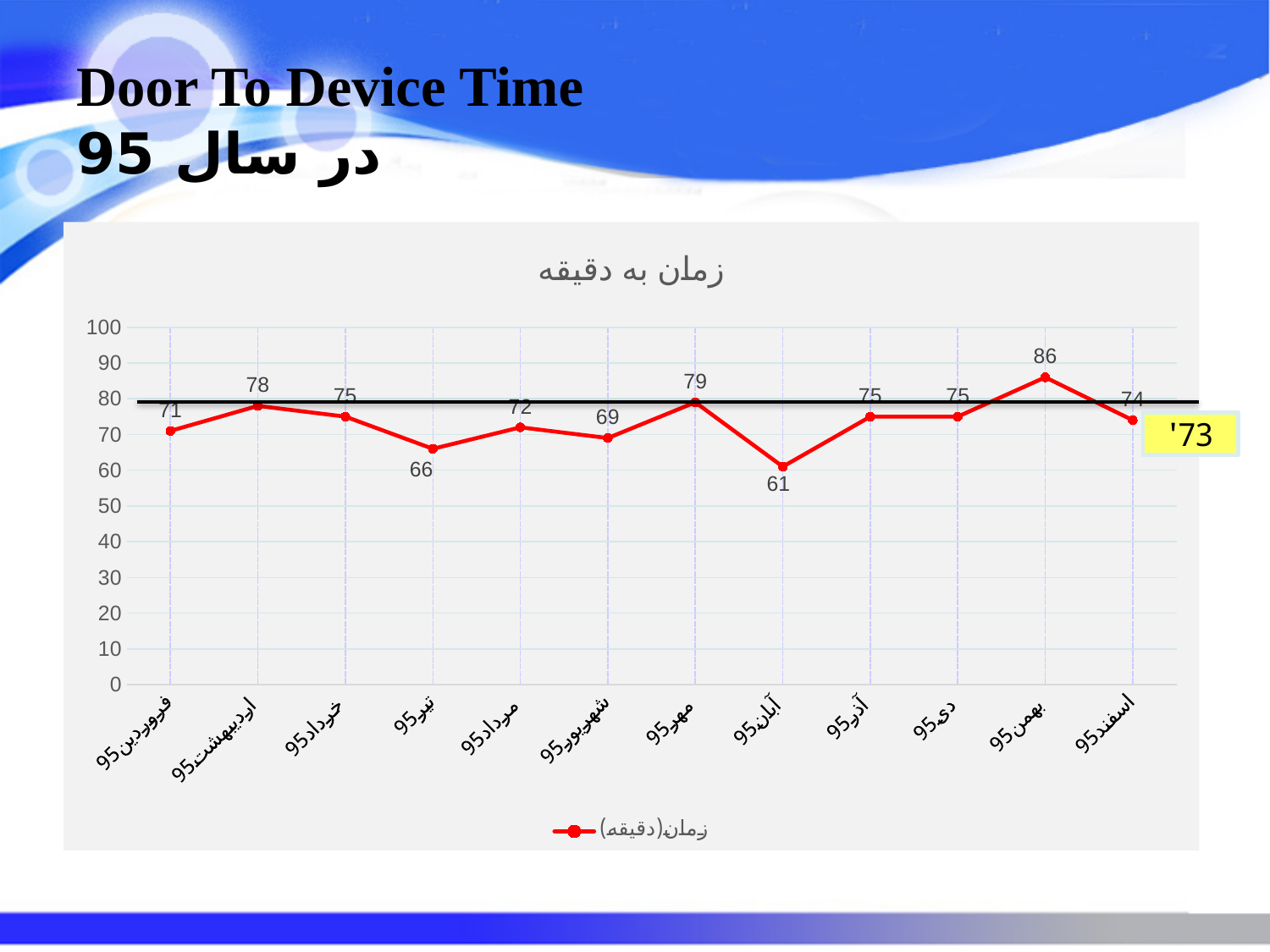
What is the value for فروردین95? 71 What is the difference between the values for بهمن95 and آبان95? 25 Which is larger, the value for اردیبهشت95 or the value for مرداد95? اردیبهشت95 What is the value for آبان95? 61 Which month has the lowest value? آبان95 What is the value for تیر95? 66 How many series does the legend list? 1 What is the title of the chart? زمان به دقیقه How many data points are plotted on the line? 12 What type of chart is shown on the slide? line chart What is the value for بهمن95? 86 Which month has the highest value? بهمن95